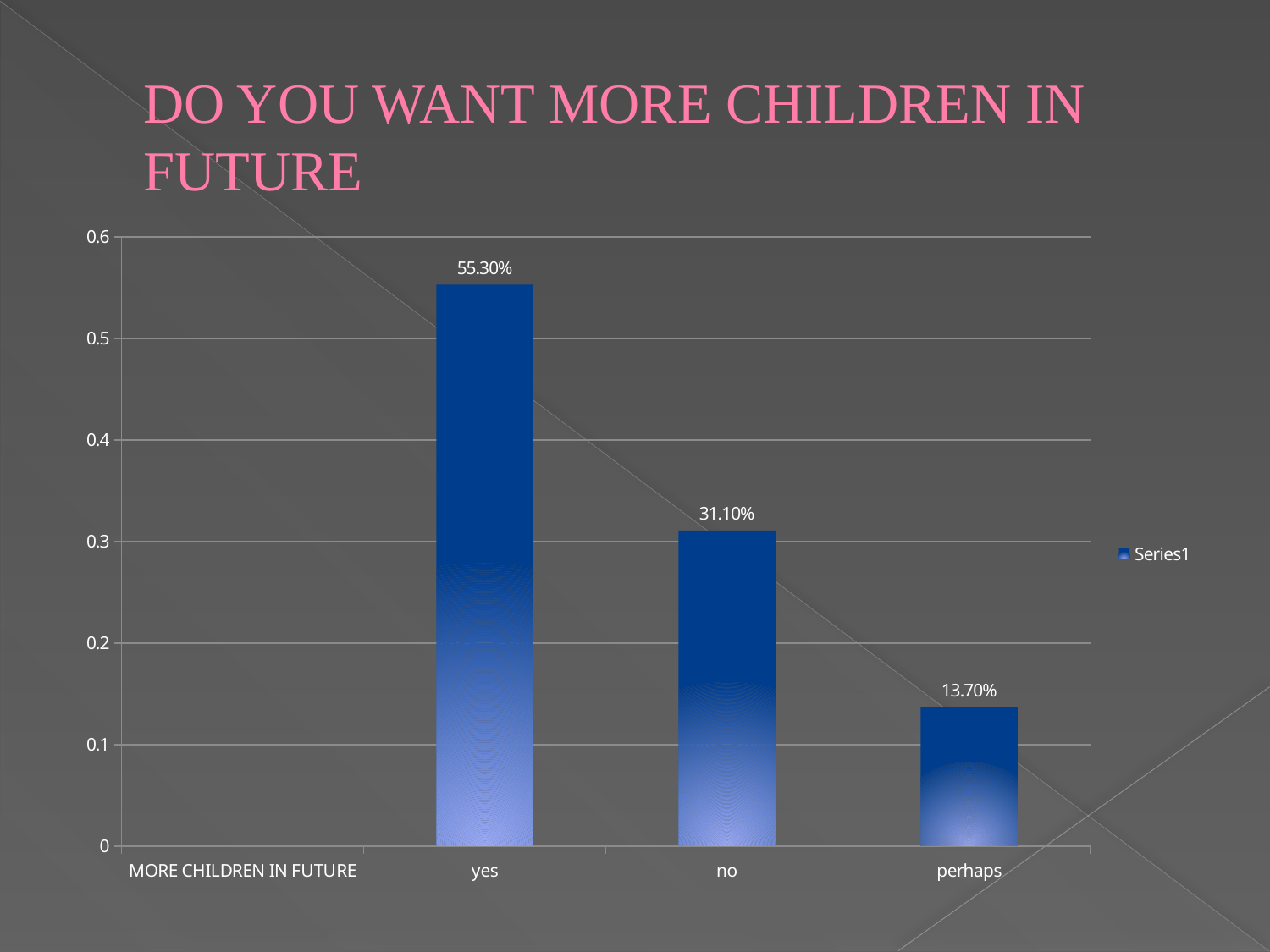
What is the value for "yes"? 55.30% Which category has the highest value? yes Which is larger, the value for "no" or the value for "perhaps"? no What is the title of the slide? DO YOU WANT MORE CHILDREN IN FUTURE What is the value for "perhaps"? 13.70% What is the difference between the values for "no" and "perhaps"? 17.40% How many bars are plotted in the chart? 3 What is the difference between the values for "yes" and "no"? 24.20% Which category has the lowest value? perhaps What kind of chart is shown on the slide? bar chart What is the value for "no"? 31.10% Is the value for "yes" greater or less than 0.5? greater